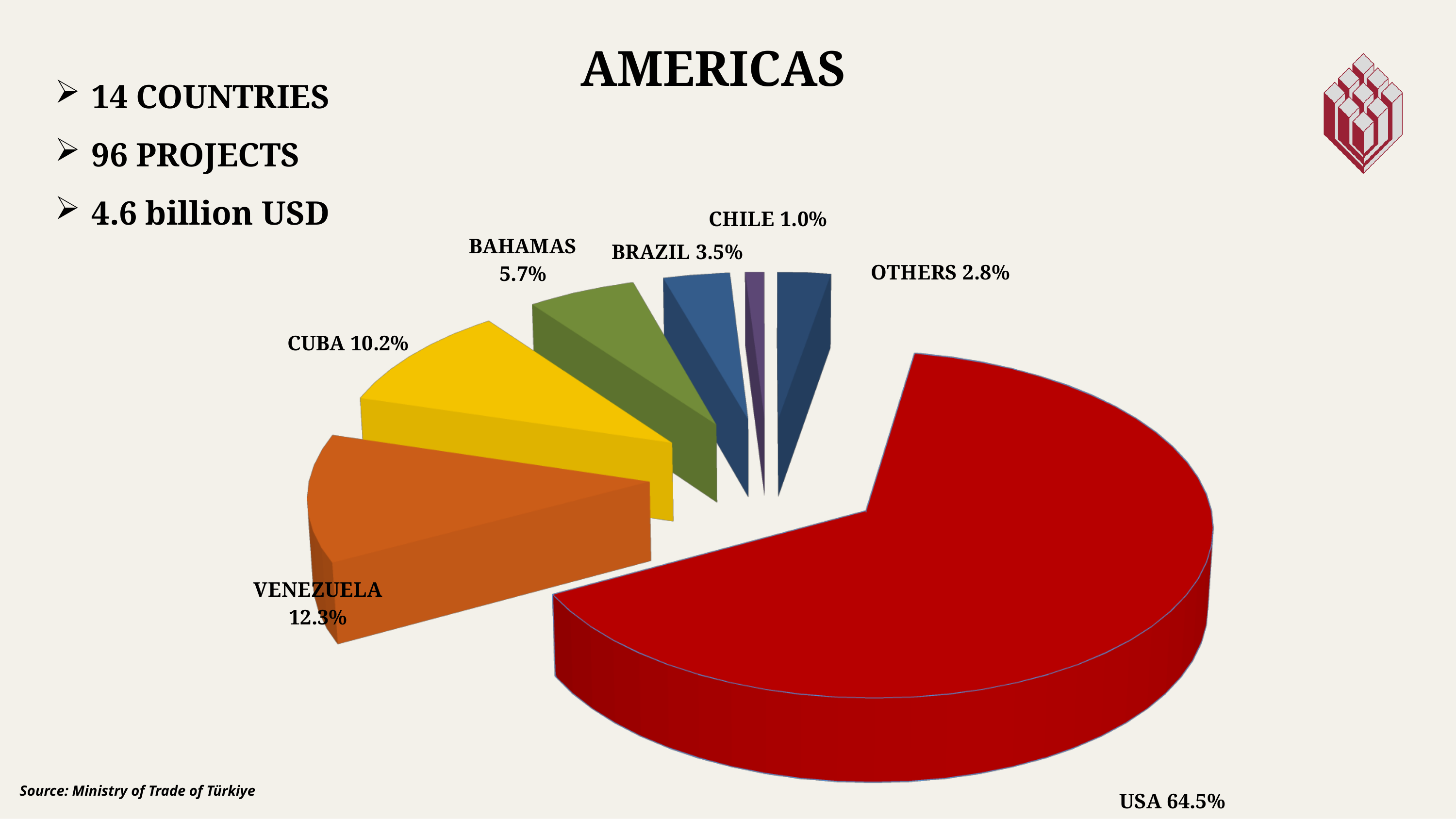
What is the value shown for Venezuela? 12.3% What is the title of the chart? AMERICAS Which labelled slice is the smallest? Chile What share of the pie does USA hold? 64.5% Which is larger, the share for Brazil or the share for Others? Brazil What percentage is labelled for Cuba? 10.2% What is the difference between the shares of Venezuela and Cuba? 2.1% Which country has the largest slice of the pie? USA What kind of chart is shown on the slide? Pie chart What is the value for Bahamas? 5.7% What colour is the USA slice? Red How many slices does the pie chart have? 7